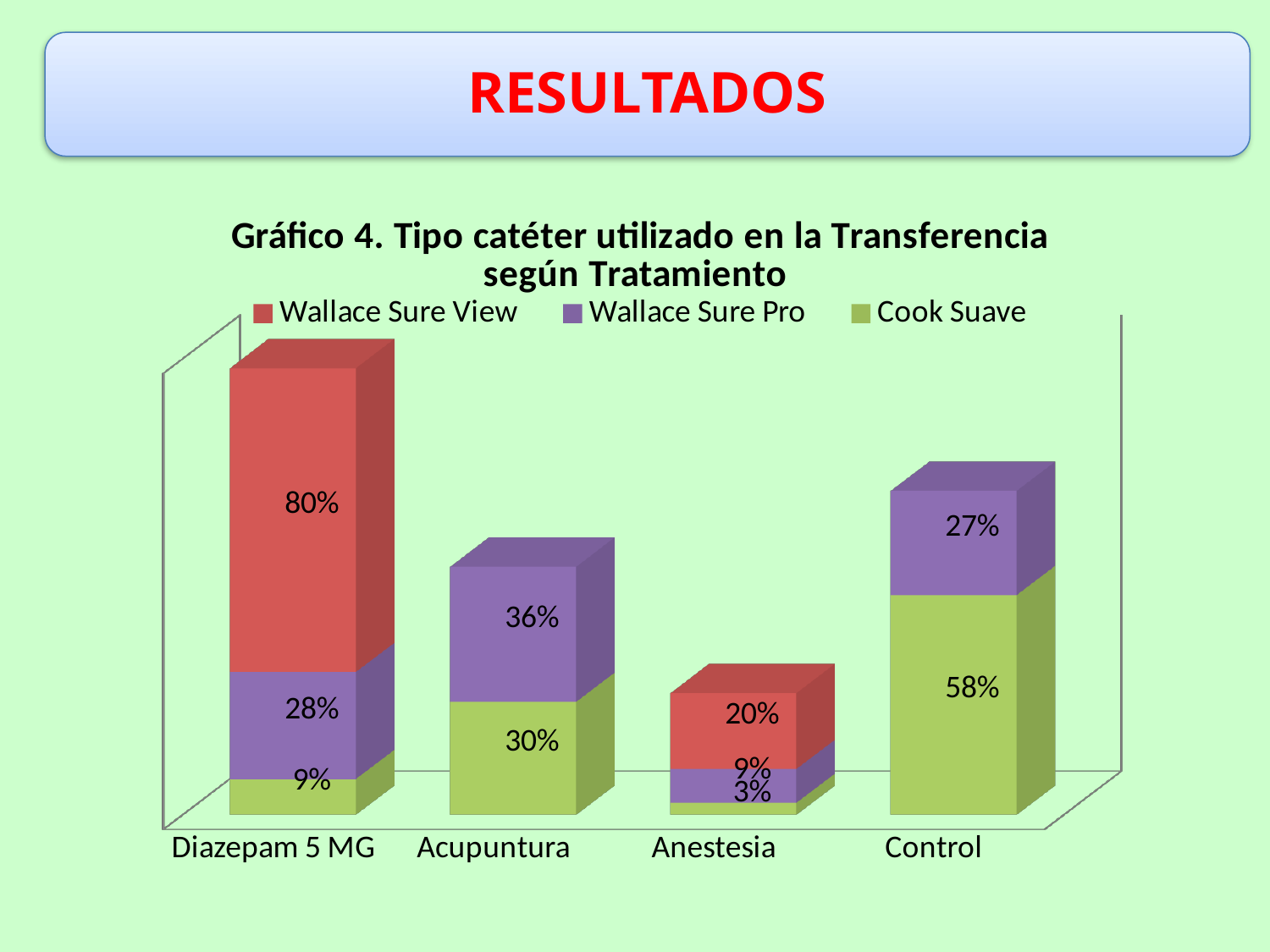
Which is larger: the Wallace Sure Pro value for Diazepam 5 MG or for Control? Diazepam 5 MG How many series does the legend list? 3 What is the value for Cook Suave in the Control bar? 58% What is the value for Wallace Sure Pro in the Acupuntura bar? 36% How many treatment categories are shown on the x axis? 4 Which treatment has the lowest value for Cook Suave? Anestesia Which treatment has the highest value for Cook Suave? Control What is the difference between the Wallace Sure View values for Diazepam 5 MG and Anestesia? 60% What type of chart is shown on the slide? Stacked bar chart What is the title of the chart? Gráfico 4. Tipo catéter utilizado en la Transferencia según Tratamiento What is the value for Wallace Sure View in the Diazepam 5 MG bar? 80% What is the value for Cook Suave in the Anestesia bar? 3%